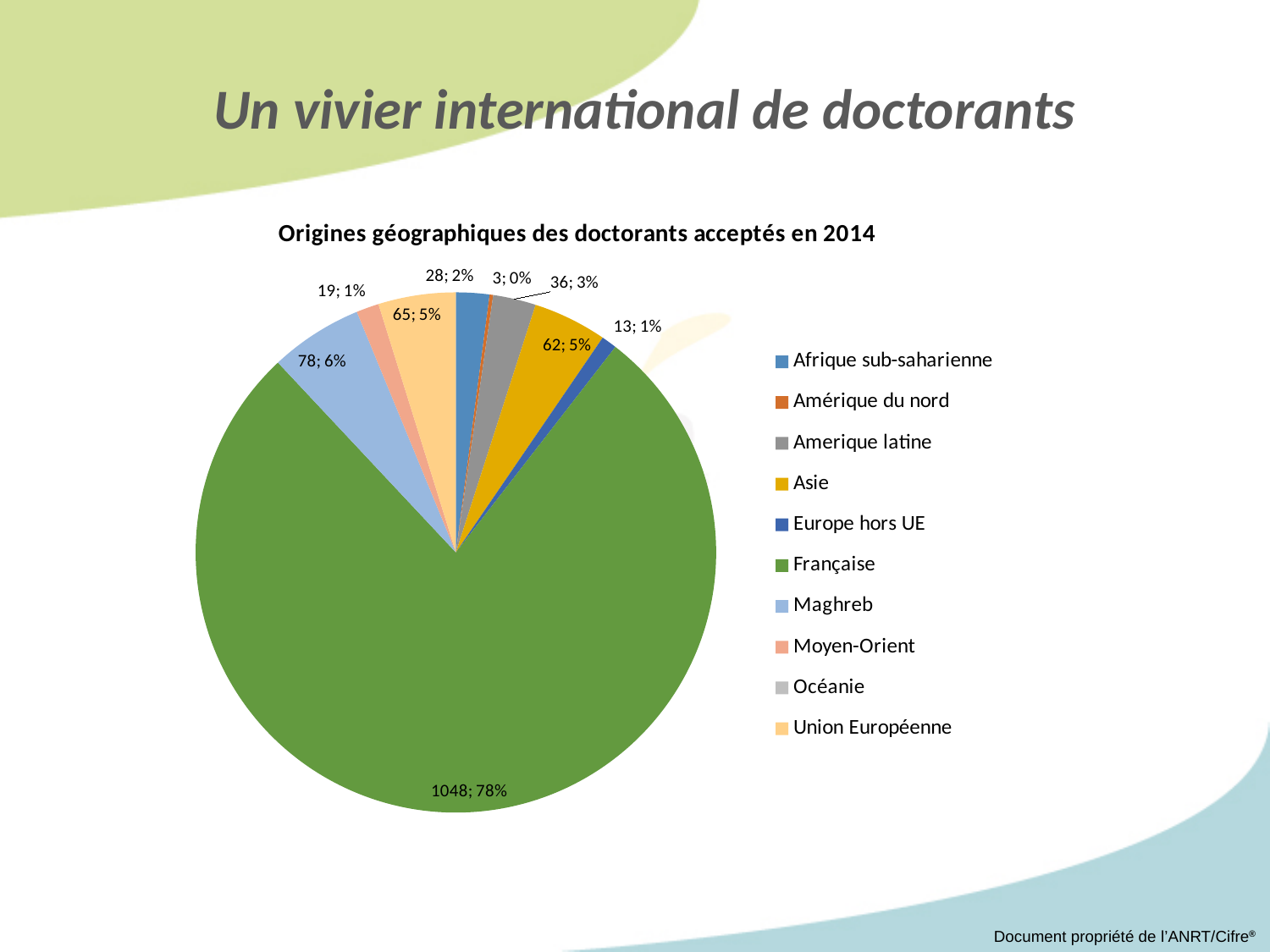
Which category has the largest slice of the pie? Française What is the value shown for the Europe hors UE slice? 13 What share of the pie does the Asie slice represent? 5% Which is larger, the Asie slice or the Amerique latine slice? Asie What is the value shown for the Maghreb slice? 78 What share of the pie does the Française slice represent? 78% What is the title of the chart? Origines géographiques des doctorants acceptés en 2014 What is the value shown for the Française slice? 1048 What is the difference between the Maghreb value and the Union Européenne value? 13 How many categories does the legend list? 10 What is the value shown for the Amérique du nord slice? 3 What kind of chart is shown on the slide? pie chart